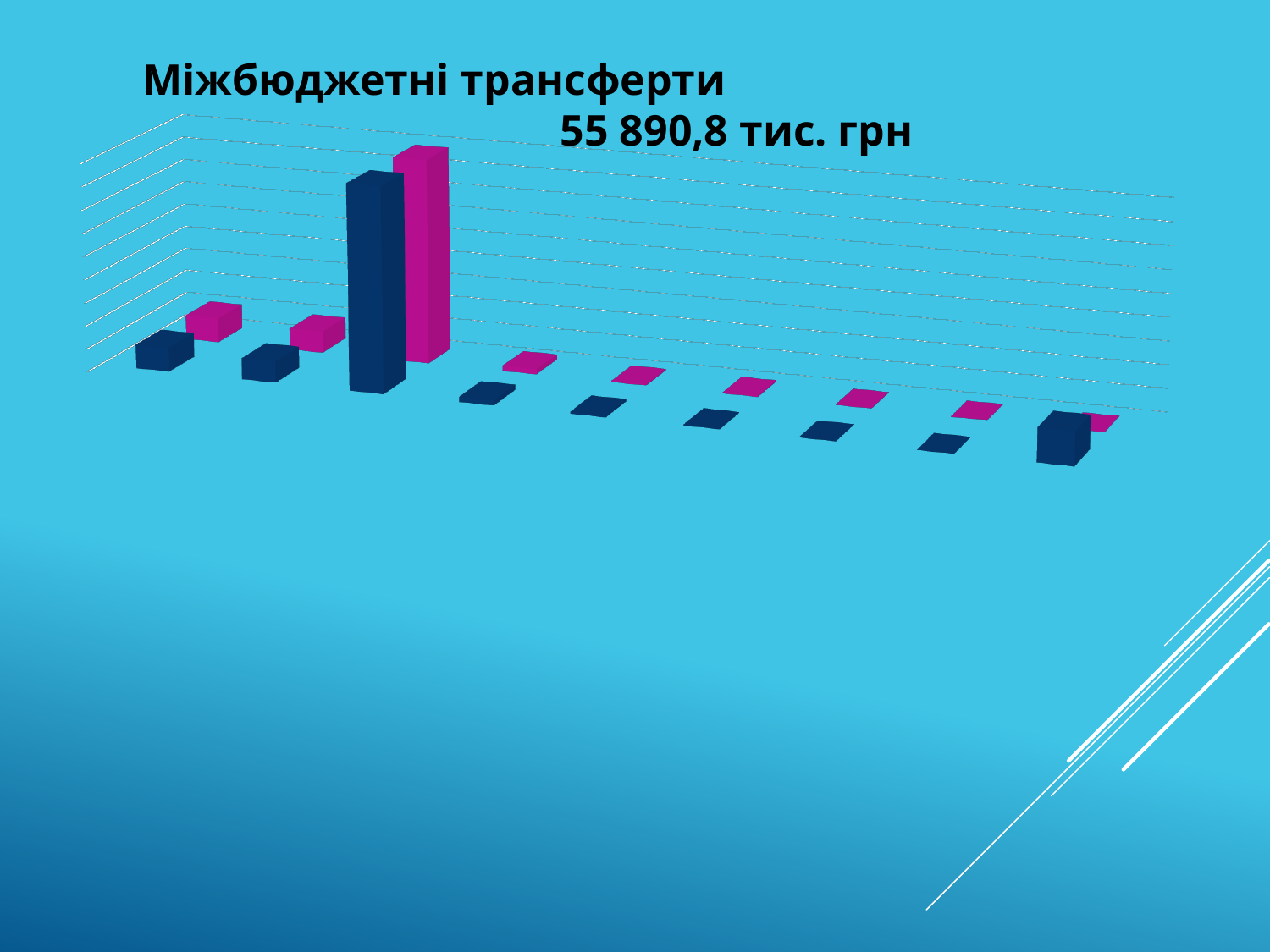
What is the title of the chart? Міжбюджетні трансферти How many groups of bars (categories) are plotted in the chart? 9 What total amount is stated in the chart heading? 55 890,8 тис. грн How many differently coloured bar series are plotted in the chart? 2 Counting from the left, which group of bars is the tallest in the chart? the third What kind of chart is shown on the slide? bar chart